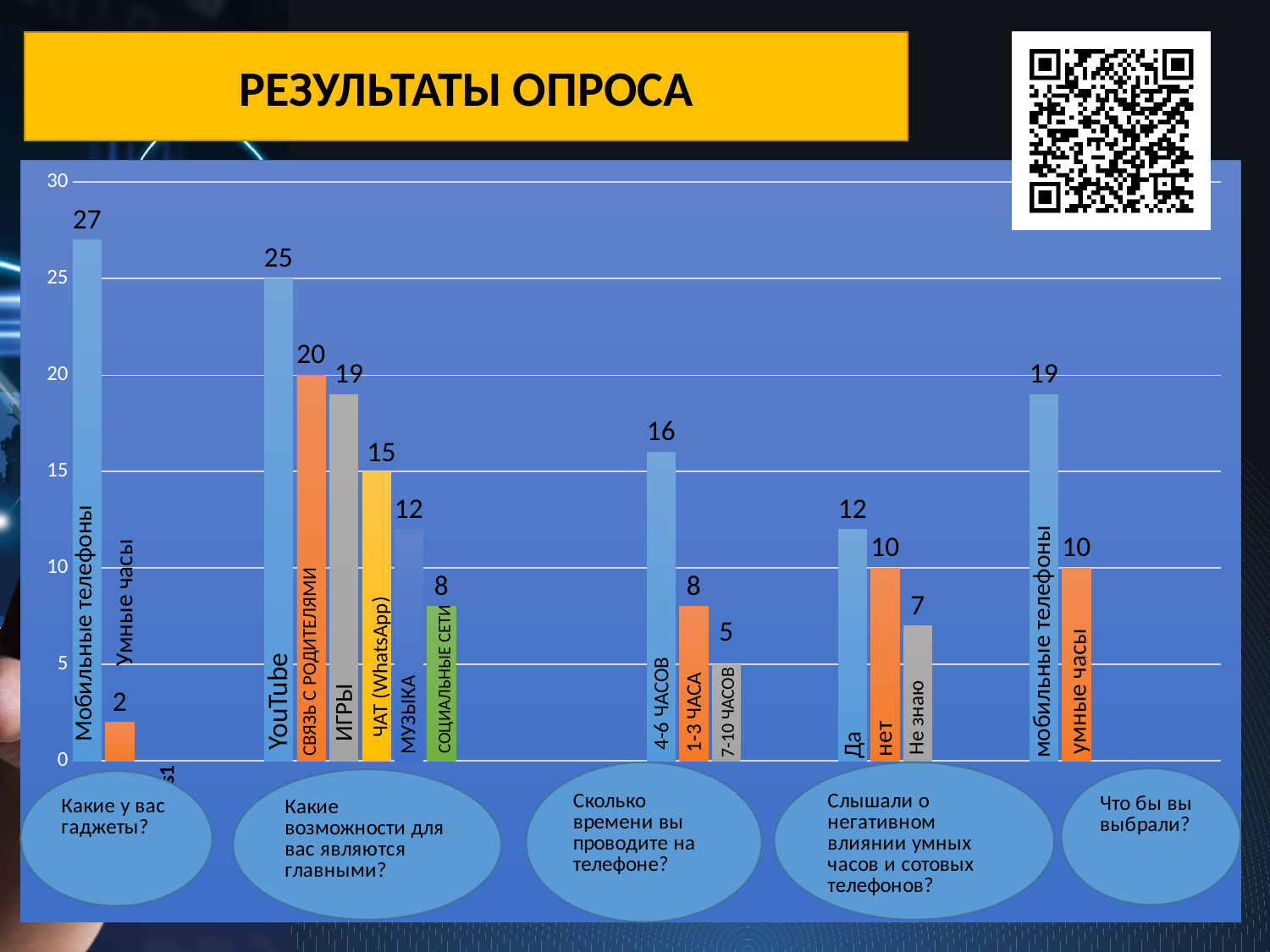
What is the value for "Мобильные телефоны" in the group "Какие у вас гаджеты?"? 27 What is the value for "ЧАТ (WhatsApp)"? 15 Which bar has the highest value on the whole chart? Мобильные телефоны (Какие у вас гаджеты?) What is the difference between "Мобильные телефоны" and "Умные часы" in the group "Что бы вы выбрали?"? 9 How many bars are in the group "Какие возможности для вас являются главными?"? 6 What is the title of the slide containing the chart? РЕЗУЛЬТАТЫ ОПРОСА What is the value for "YouTube"? 25 What is the value for "Умные часы" in the group "Какие у вас гаджеты?"? 2 What type of chart is shown on the slide? bar chart Which bar has the lowest value on the whole chart? Умные часы (Какие у вас гаджеты?) Which is larger, the value for "Да" or the value for "нет" in the group about the negative influence of smart watches and phones? Да What is the difference between the values for "4-6 ЧАСОВ" and "7-10 ЧАСОВ"? 11